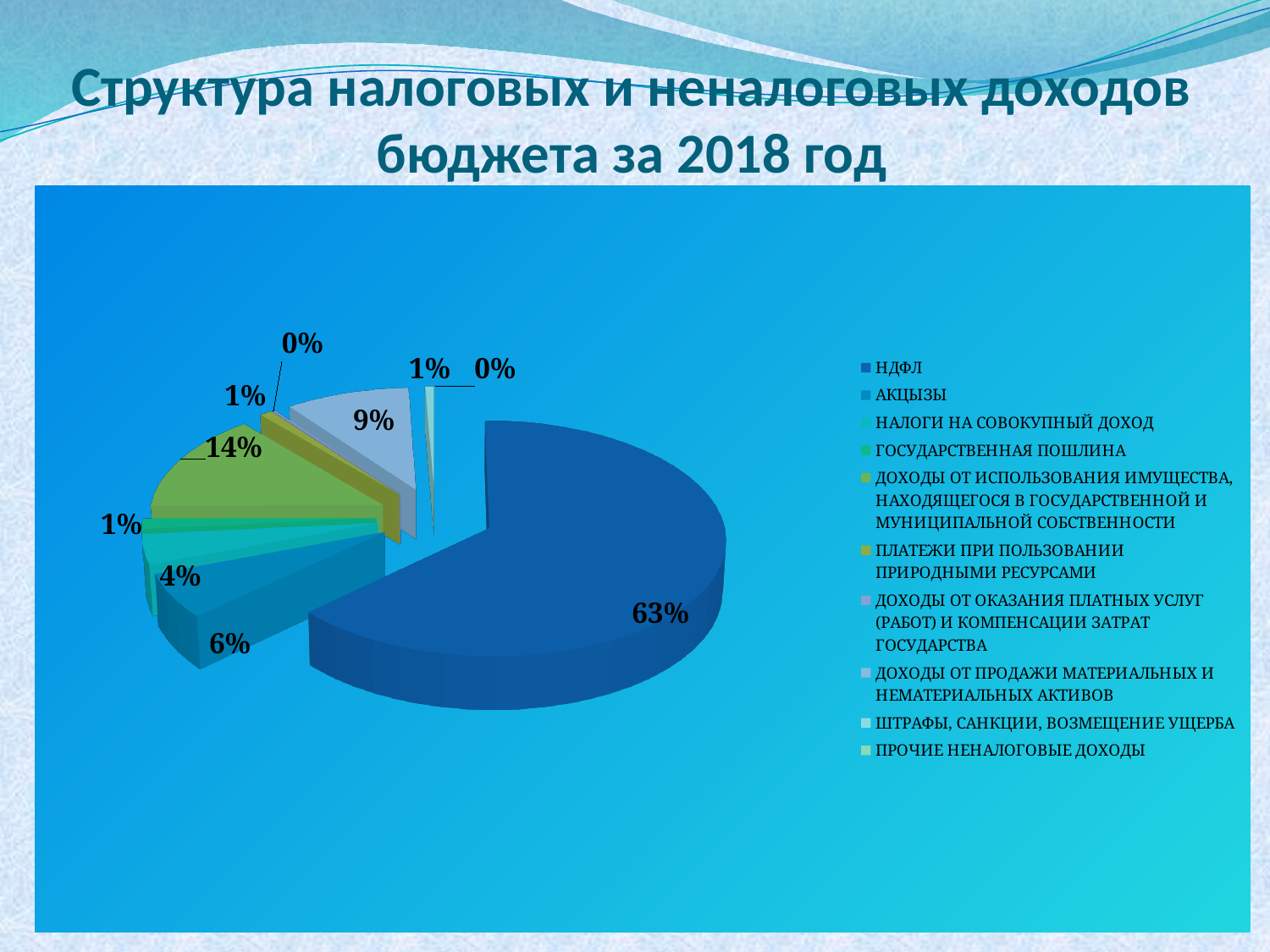
How many entries does the legend of the pie chart list? 10 What is the value shown for АКЦИЗЫ? 6% What is the title of the slide containing the pie chart? Структура налоговых и неналоговых доходов бюджета за 2018 год What is the value shown for ДОХОДЫ ОТ ИСПОЛЬЗОВАНИЯ ИМУЩЕСТВА, НАХОДЯЩЕГОСЯ В ГОСУДАРСТВЕННОЙ И МУНИЦИПАЛЬНОЙ СОБСТВЕННОСТИ? 14% Which is larger: the share for НДФЛ or the share for ДОХОДЫ ОТ ПРОДАЖИ МАТЕРИАЛЬНЫХ И НЕМАТЕРИАЛЬНЫХ АКТИВОВ? НДФЛ What is the combined share of the 63% slice and the 14% slice? 77% What is the difference in percentage points between the НДФЛ slice (63%) and the 14% slice? 49 What share of the pie does НДФЛ account for? 63% How many data labels are printed on the pie chart? 10 Which category has the largest share of the pie chart? НДФЛ What kind of chart is shown on the slide? pie chart What is the value shown for ДОХОДЫ ОТ ПРОДАЖИ МАТЕРИАЛЬНЫХ И НЕМАТЕРИАЛЬНЫХ АКТИВОВ? 9%